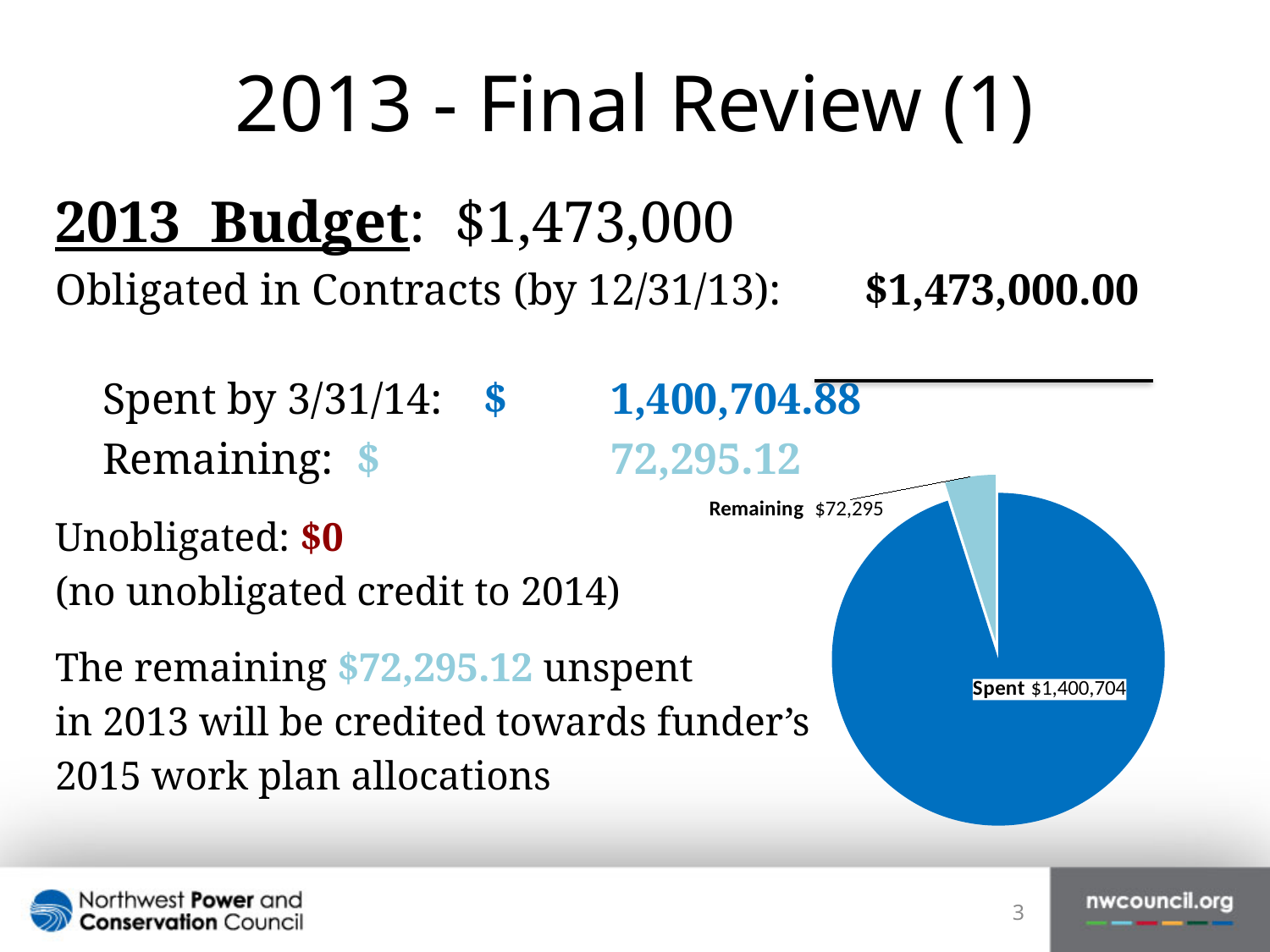
What kind of chart is shown on the slide? pie chart Which is larger in the pie chart, Spent or Remaining? Spent In the pie chart, what is the value of the Spent slice? $1,400,704 What is the total of the two slices in the pie chart? $1,473,000 Which slice of the pie chart is the largest? Spent How many slices does the pie chart have? 2 What colour is the Remaining slice in the pie chart? light blue What share of the pie chart does the Remaining slice represent, to one decimal place? 4.9% Which slice of the pie chart is the smallest? Remaining In the pie chart, what is the value of the Remaining slice? $72,295 What colour is the Spent slice in the pie chart? dark blue What is the difference between the Spent and Remaining values in the pie chart? $1,328,409